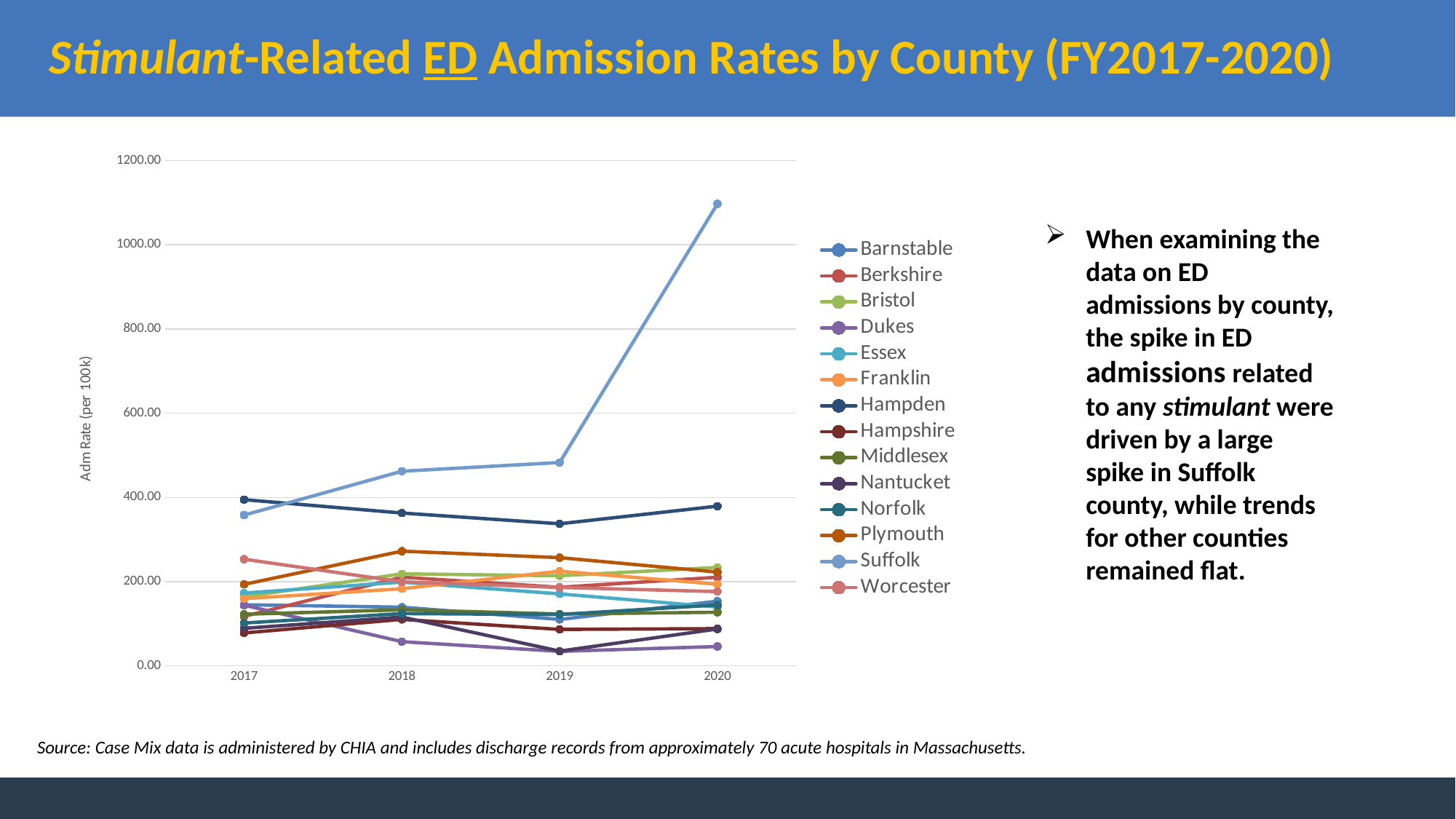
Is the value for Hampden in 2019 greater or less than 400? less What is the label on the y axis of the chart? Adm Rate (per 100k) In 2020, which is larger, the value for Suffolk or the value for Hampden? Suffolk What kind of chart is shown on the slide? line chart How many years are plotted along the x axis? 4 Is the value for Suffolk in 2017 greater or less than 400? less Which county has the highest ED admission rate in 2020? Suffolk How many counties (series) does the legend list? 14 Does the Suffolk line rise or fall from 2017 to 2020? rise Is the value for Suffolk in 2019 greater or less than 400? greater